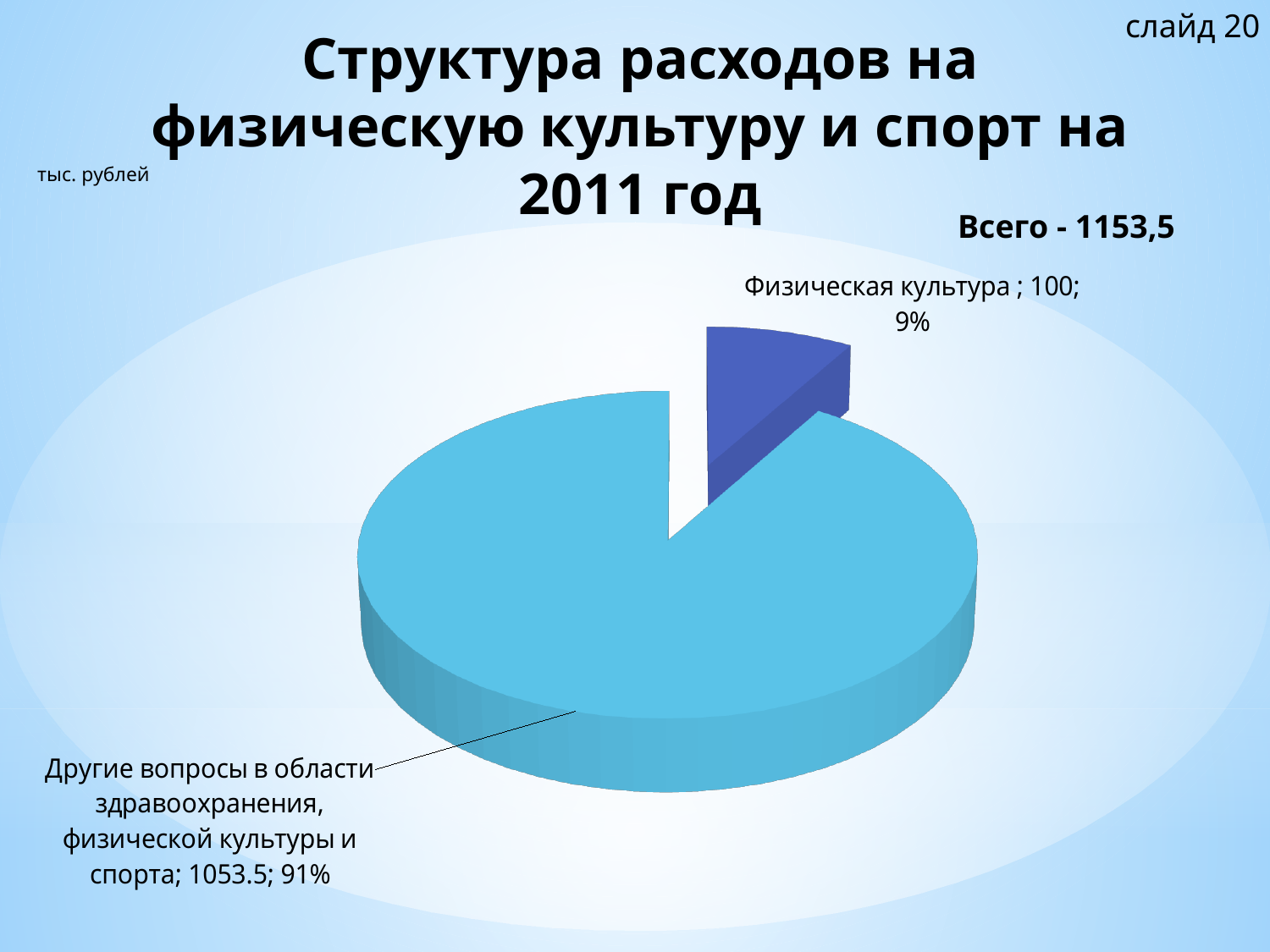
What is the difference between the values for Другие вопросы в области здравоохранения, физической культуры и спорта and Физическая культура? 953.5 What is the value for Другие вопросы в области здравоохранения, физической культуры и спорта? 1053.5 What share of the pie does Физическая культура represent? 9% How many slices does the pie chart have? 2 What is the value for Физическая культура? 100 What share of the pie does Другие вопросы в области здравоохранения, физической культуры и спорта represent? 91% Which is larger: the value for Физическая культура or the value for Другие вопросы в области здравоохранения, физической культуры и спорта? Другие вопросы в области здравоохранения, физической культуры и спорта Which category has the largest slice? Другие вопросы в области здравоохранения, физической культуры и спорта What unit is indicated for the values on the slide? тыс. рублей What total is stated on the slide (Всего)? 1153,5 Which category has the smallest slice? Физическая культура What kind of chart is shown on the slide? pie chart